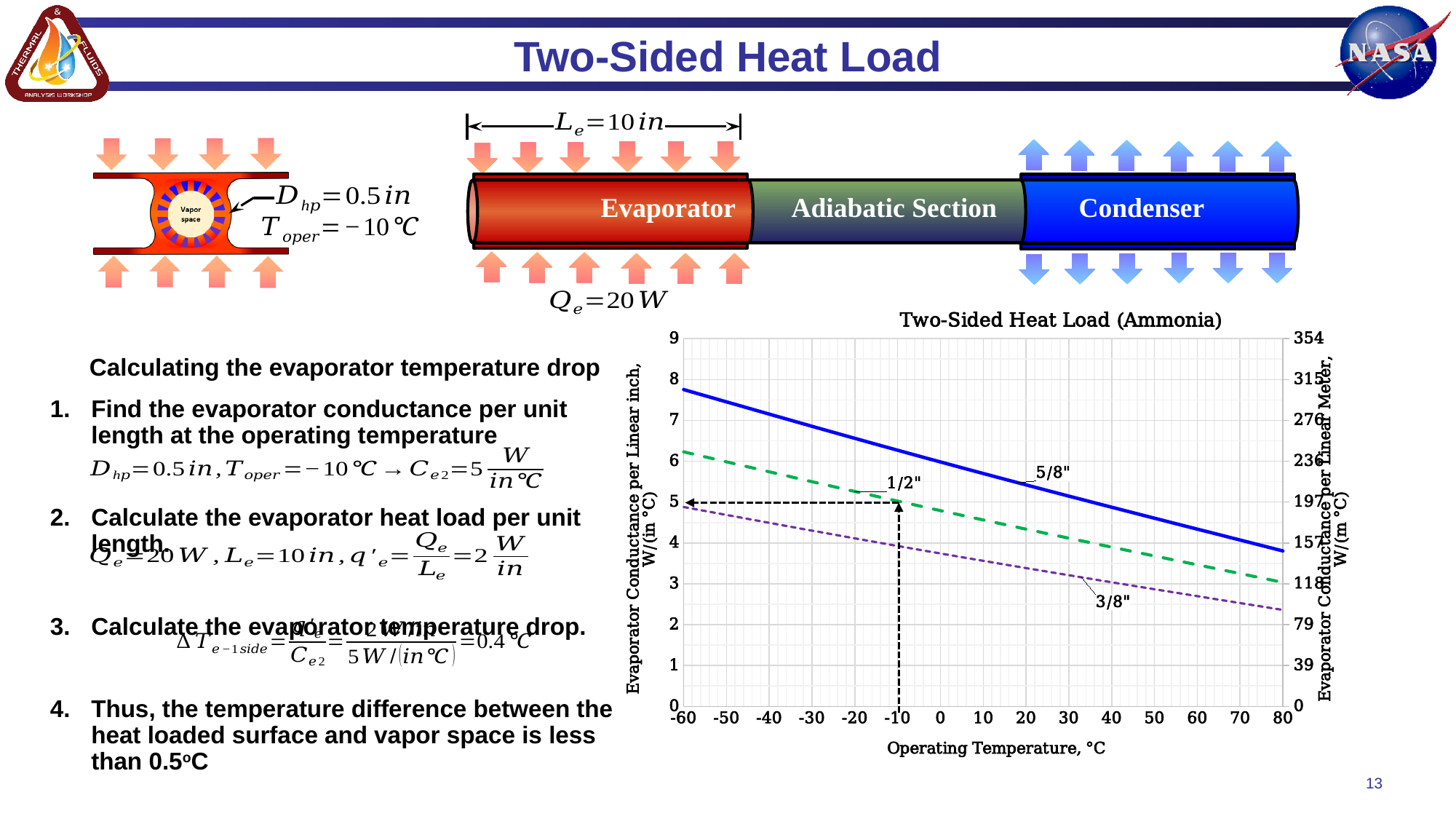
Which line has the lowest evaporator conductance across the temperature range? 3/8" Do the evaporator conductance values rise or fall as operating temperature increases? fall Is the evaporator conductance per linear inch for the 1/2" line at 80 °C greater or less than 4? less What is the title of the chart? Two-Sided Heat Load (Ammonia) Is the evaporator conductance per linear inch for the 3/8" line at 80 °C greater or less than 3? less At an operating temperature of 0 °C, which line has the larger conductance, 5/8" or 3/8"? 5/8" Which line has the highest evaporator conductance across the temperature range? 5/8" What type of chart is shown on the slide? line chart How many lines (pipe diameters) are plotted on the chart? 3 What is the label of the x axis of the chart? Operating Temperature, °C According to the dashed annotation on the chart, what is the evaporator conductance per linear inch for the 1/2" line at an operating temperature of -10 °C? 5 Is the evaporator conductance per linear inch for the 5/8" line at -60 °C greater or less than 7? greater